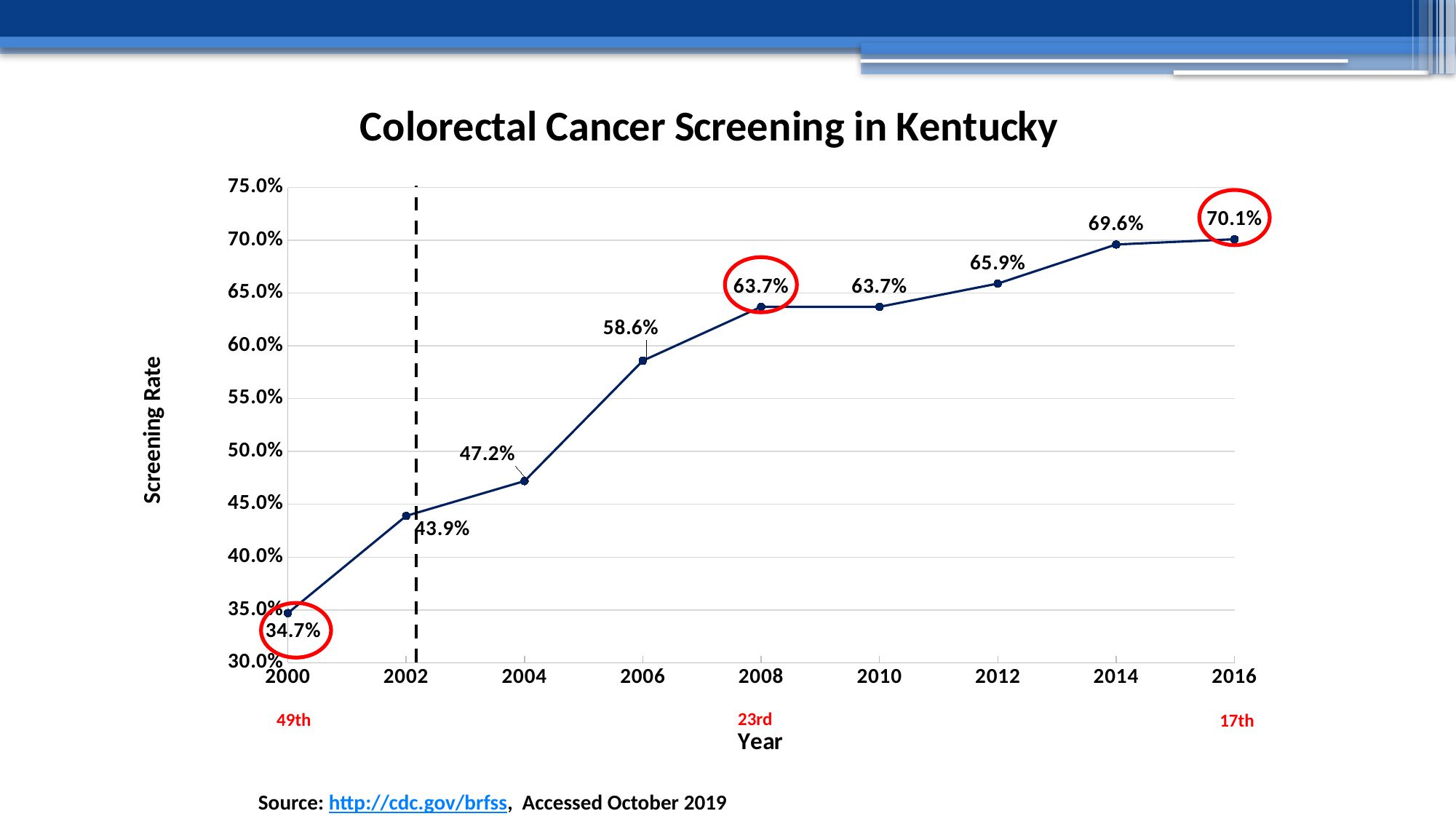
What was the screening rate in 2006? 58.6% What was the screening rate in 2012? 65.9% What type of chart is shown on the slide? Line chart Does the screening rate generally rise or fall from 2000 to 2016? Rise What was the screening rate in 2016? 70.1% What is the difference between the screening rates in 2004 and 2006? 11.4 percentage points Which year had a higher screening rate, 2002 or 2004? 2004 By how many percentage points did the screening rate increase from 2000 to 2016? 35.4 percentage points How many data points are plotted on the chart? 9 What was the colorectal cancer screening rate in Kentucky in 2000? 34.7% Which year has the lowest screening rate? 2000 Which year has the highest screening rate? 2016